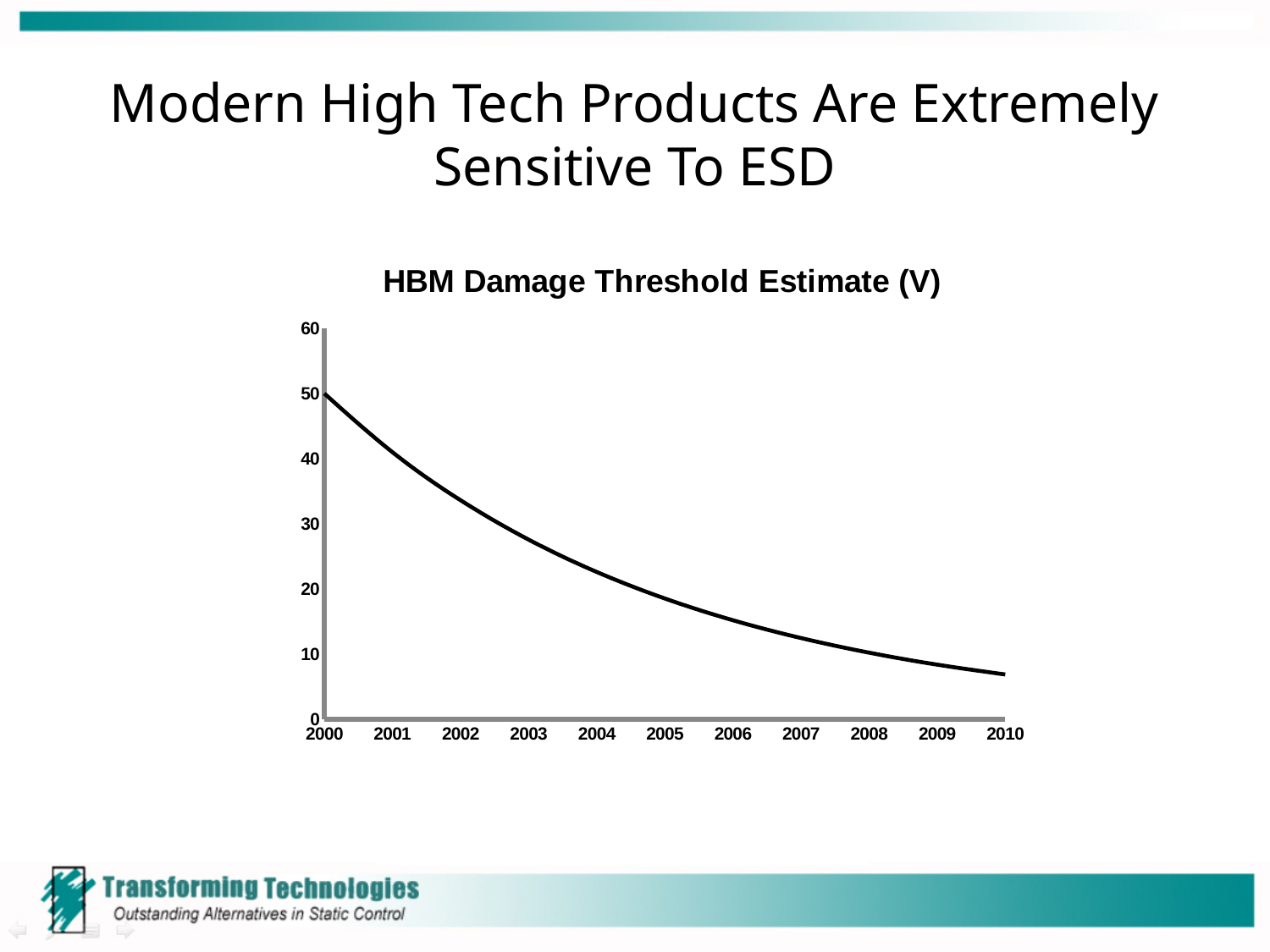
Do the values rise or fall from 2000 to 2010? fall Is the value for 2010 greater or less than 10? less Is the value for 2003 greater or less than 20? greater Is the value for 2006 greater or less than 20? less Which year has the lowest HBM damage threshold estimate? 2010 Which year has the highest HBM damage threshold estimate? 2000 What is the HBM damage threshold estimate for 2000? 50 Which is larger, the value for 2001 or the value for 2007? 2001 How many years are labelled on the x axis? 11 What kind of chart is shown on the slide? line chart What is the title of the chart? HBM Damage Threshold Estimate (V)